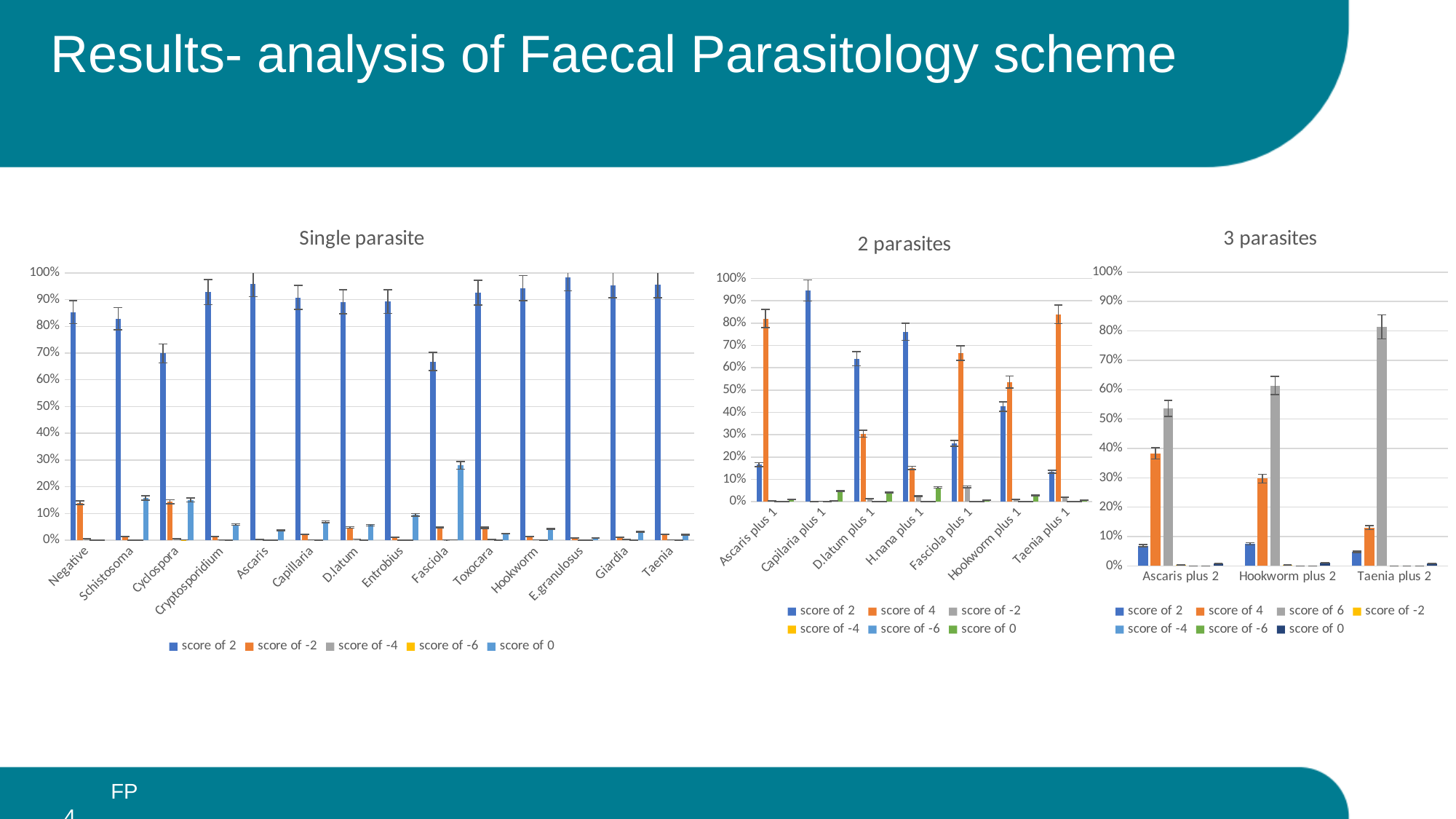
In the 'Single parasite' chart, is the 'score of 2' value for Cyclospora greater or less than 60%? greater How many series does the legend of the 'Single parasite' chart list? 5 In the '2 parasites' chart, which is larger for Ascaris plus 1: the 'score of 2' value or the 'score of 4' value? score of 4 How many categories are shown on the x axis of the '3 parasites' chart? 3 In the '2 parasites' chart, is the 'score of 2' value for Hookworm plus 1 greater or less than 50%? less How many series does the legend of the '2 parasites' chart list? 6 How many charts are on the slide? 3 In the '3 parasites' chart, which category has the highest 'score of 6' value? Taenia plus 2 In the 'Single parasite' chart, is the 'score of 0' value for Fasciola greater or less than 20%? greater What kind of chart is the 'Single parasite' chart? Bar chart In the 'Single parasite' chart, which is larger: the 'score of 2' value for Negative or for Cyclospora? Negative How many categories are shown on the x axis of the 'Single parasite' chart? 14